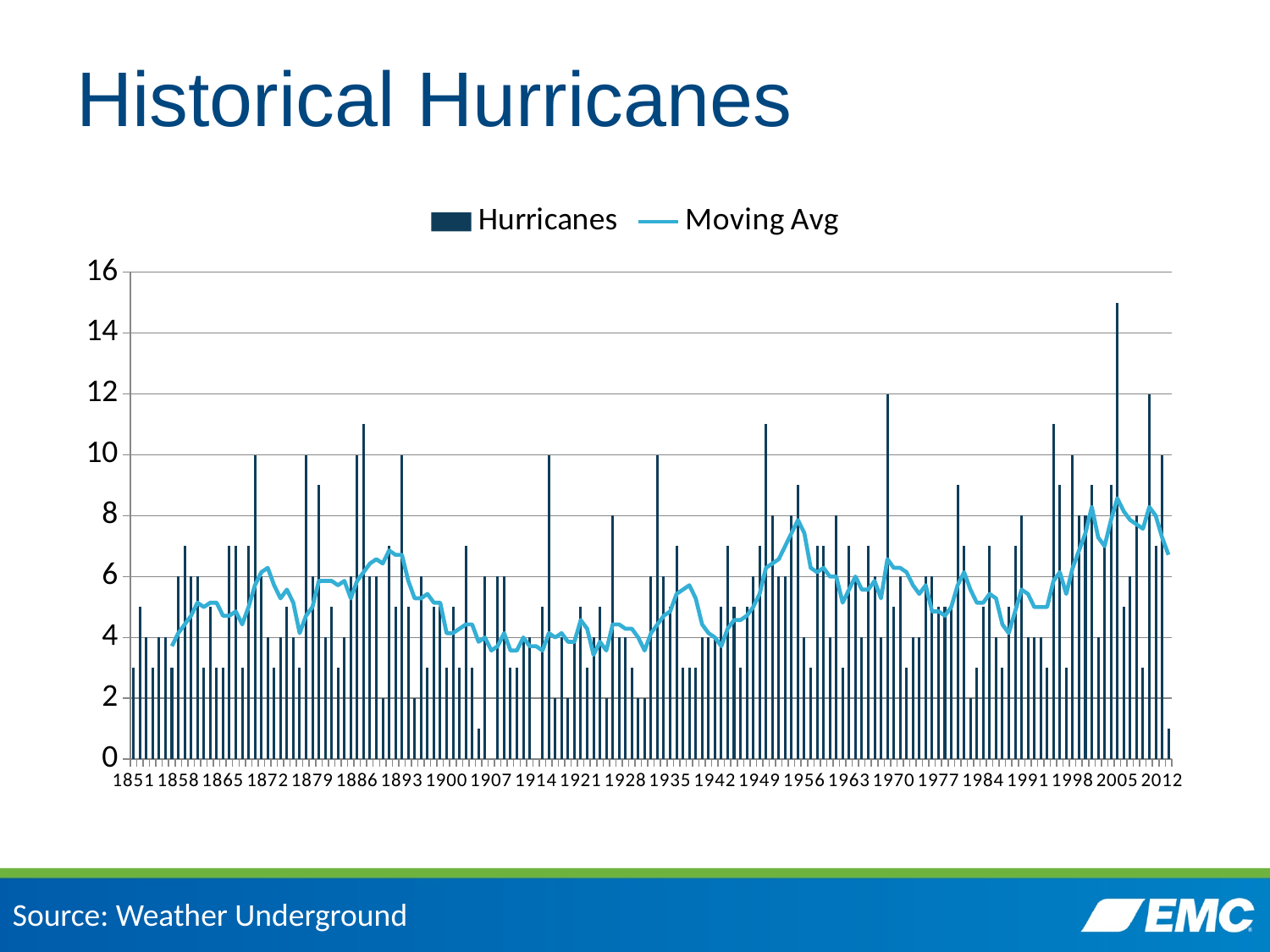
Is the highest point of the Moving Avg line greater or less than 10? less Does the Moving Avg line rise or fall between 1942 and 1956? rise What is the title of the slide containing the chart? Historical Hurricanes What kind of chart is shown on the slide? combination bar and line chart What are the two series named in the legend? Hurricanes and Moving Avg Is the value for 1851 greater or less than 4? less What is the first year shown on the x axis? 1851 Does the Moving Avg line rise or fall between 1956 and 1963? fall Is the tallest Hurricanes bar greater or less than 14? greater How many series does the legend list? 2 What is the last year labeled on the x axis? 2012 In which labeled year does the tallest Hurricanes bar occur? 2005